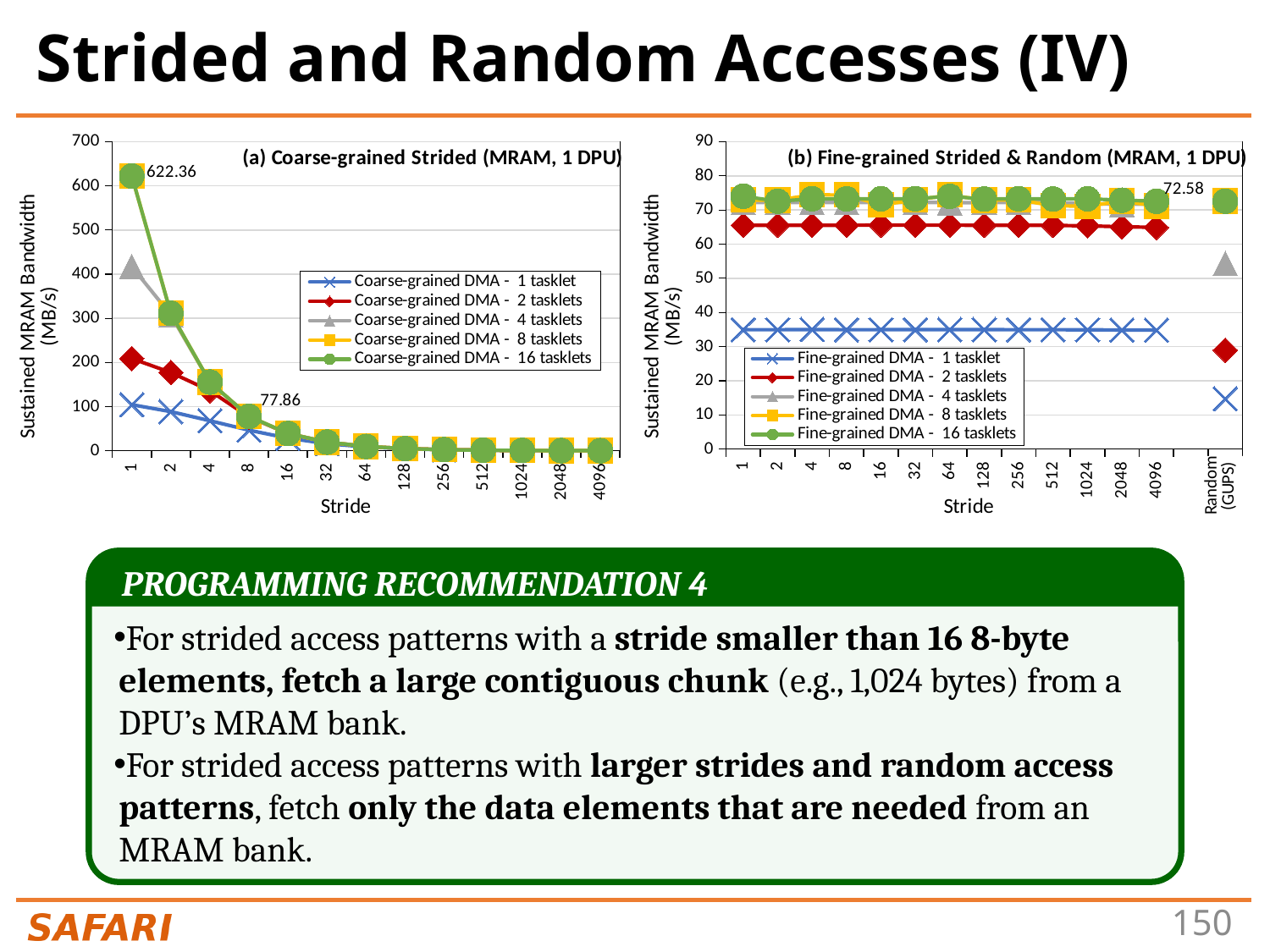
In chart (b) Fine-grained Strided & Random, which series has the lowest bandwidth across the stride values? Fine-grained DMA - 1 tasklet In chart (a) Coarse-grained Strided, do the bandwidth values rise or fall as the stride increases? fall In chart (b) Fine-grained Strided & Random, at Random (GUPS), which is larger: Fine-grained DMA - 1 tasklet or Fine-grained DMA - 2 tasklets? Fine-grained DMA - 2 tasklets In chart (b) Fine-grained Strided & Random, what is the labeled value shown near the right end of the Fine-grained DMA - 16 tasklets series? 72.58 In chart (b) Fine-grained Strided & Random, how many categories are shown on the x axis? 14 In chart (a) Coarse-grained Strided, how many stride values are shown on the x axis? 13 In chart (a) Coarse-grained Strided, is the value for Coarse-grained DMA - 1 tasklet at stride 16 greater or less than 100? less In chart (a) Coarse-grained Strided, what is the labeled value at stride 1 for Coarse-grained DMA - 16 tasklets? 622.36 What type of chart is chart (a) Coarse-grained Strided (MRAM, 1 DPU)? line chart In chart (a) Coarse-grained Strided, how many series does the legend list? 5 In chart (b) Fine-grained Strided & Random, is the value for Fine-grained DMA - 1 tasklet at Random (GUPS) greater or less than 20? less